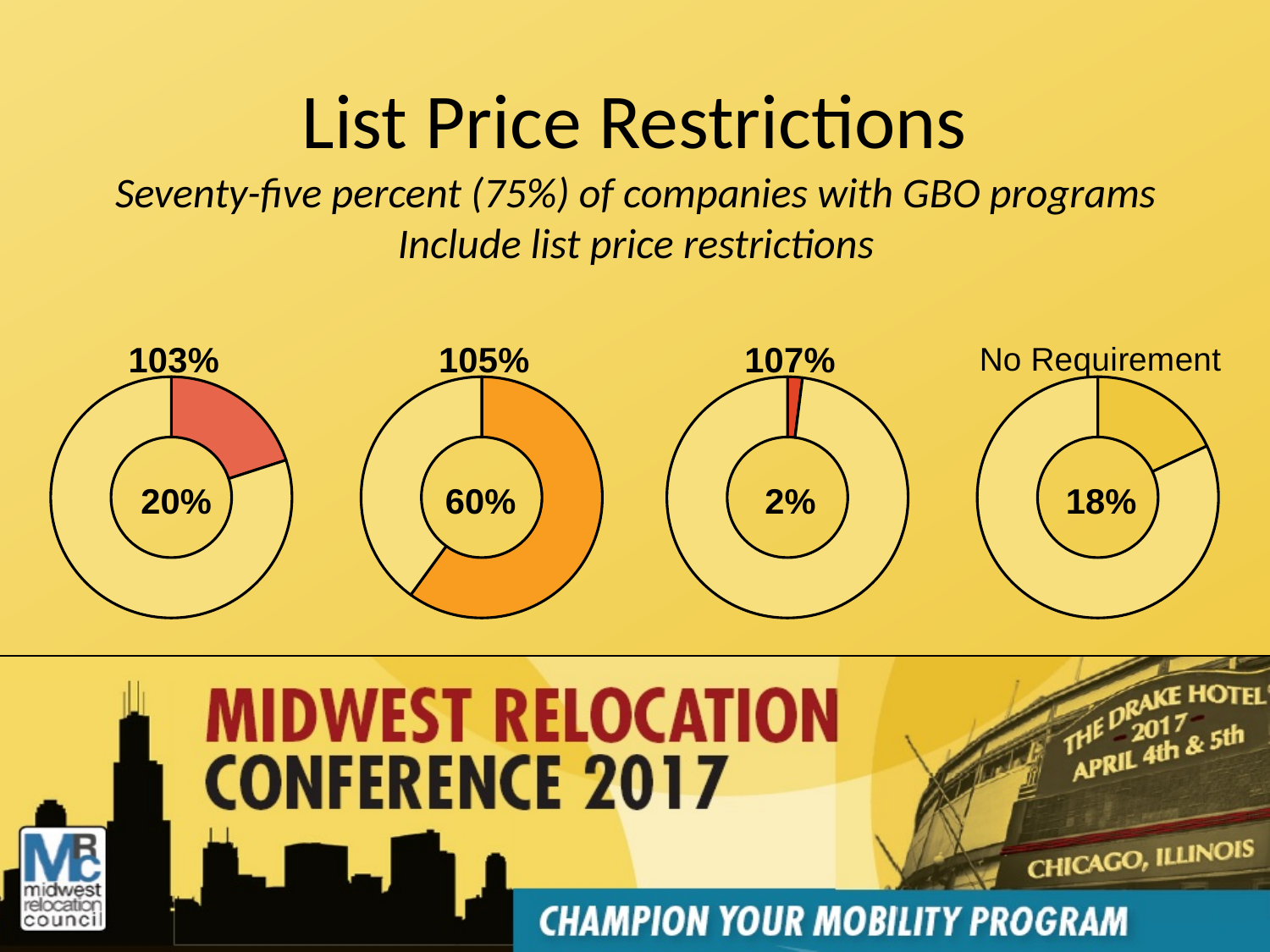
What value is shown in the centre of the donut chart labelled No Requirement? 18% What kind of chart is used to show the list price restriction percentages? Donut (pie) chart What is the difference between the value in the 105% chart and the value in the 103% chart? 40% What value is shown in the centre of the donut chart labelled 105%? 60% What value is shown in the centre of the donut chart labelled 103%? 20% What is the difference between the value in the 103% chart and the value in the No Requirement chart? 2% What value is shown in the centre of the donut chart labelled 107%? 2% Which of the four donut charts shows the highest percentage? 105% Which of the four donut charts shows the lowest percentage? 107% How many donut charts are shown on the slide? 4 What is the title of the slide containing the four donut charts? List Price Restrictions Which is larger, the value in the 103% chart or the value in the No Requirement chart? 103%